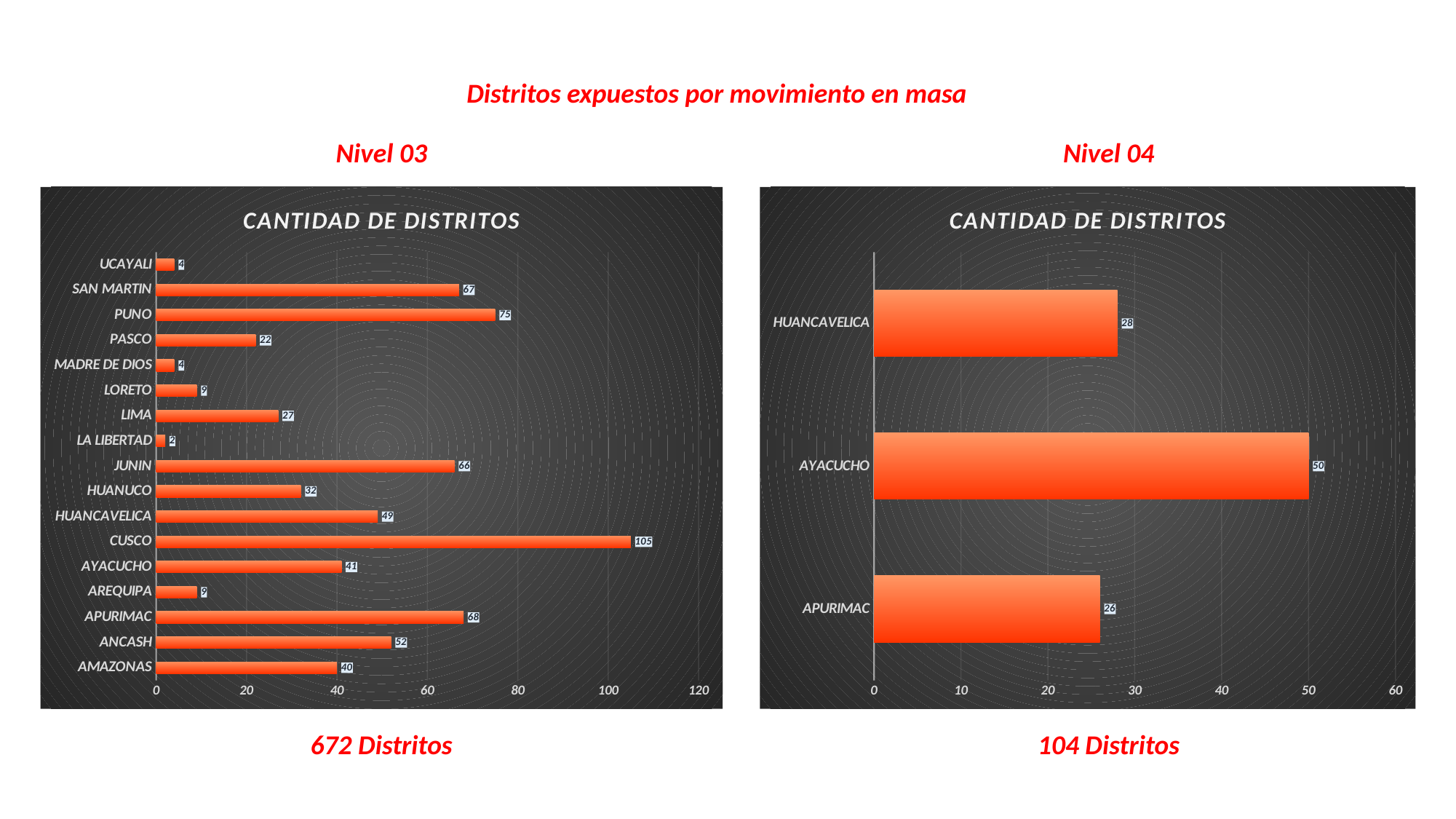
How many categories are shown in the Nivel 04 chart? 3 In the Nivel 03 chart, what is the difference between the values for APURIMAC and SAN MARTIN? 1 In the Nivel 03 chart, which category has the lowest value? LA LIBERTAD In the Nivel 04 chart, what is the value for AYACUCHO? 50 How many categories are shown in the Nivel 03 chart? 17 In the Nivel 03 chart, what is the value for CUSCO? 105 In the Nivel 03 chart, which is larger, the value for ANCASH or the value for HUANCAVELICA? ANCASH What kind of chart is the Nivel 04 chart? Bar chart In the Nivel 04 chart, what is the difference between the values for HUANCAVELICA and APURIMAC? 2 In the Nivel 04 chart, which category has the lowest value? APURIMAC In the Nivel 03 chart, which category has the highest value? CUSCO In the Nivel 03 chart, what is the value for PUNO? 75